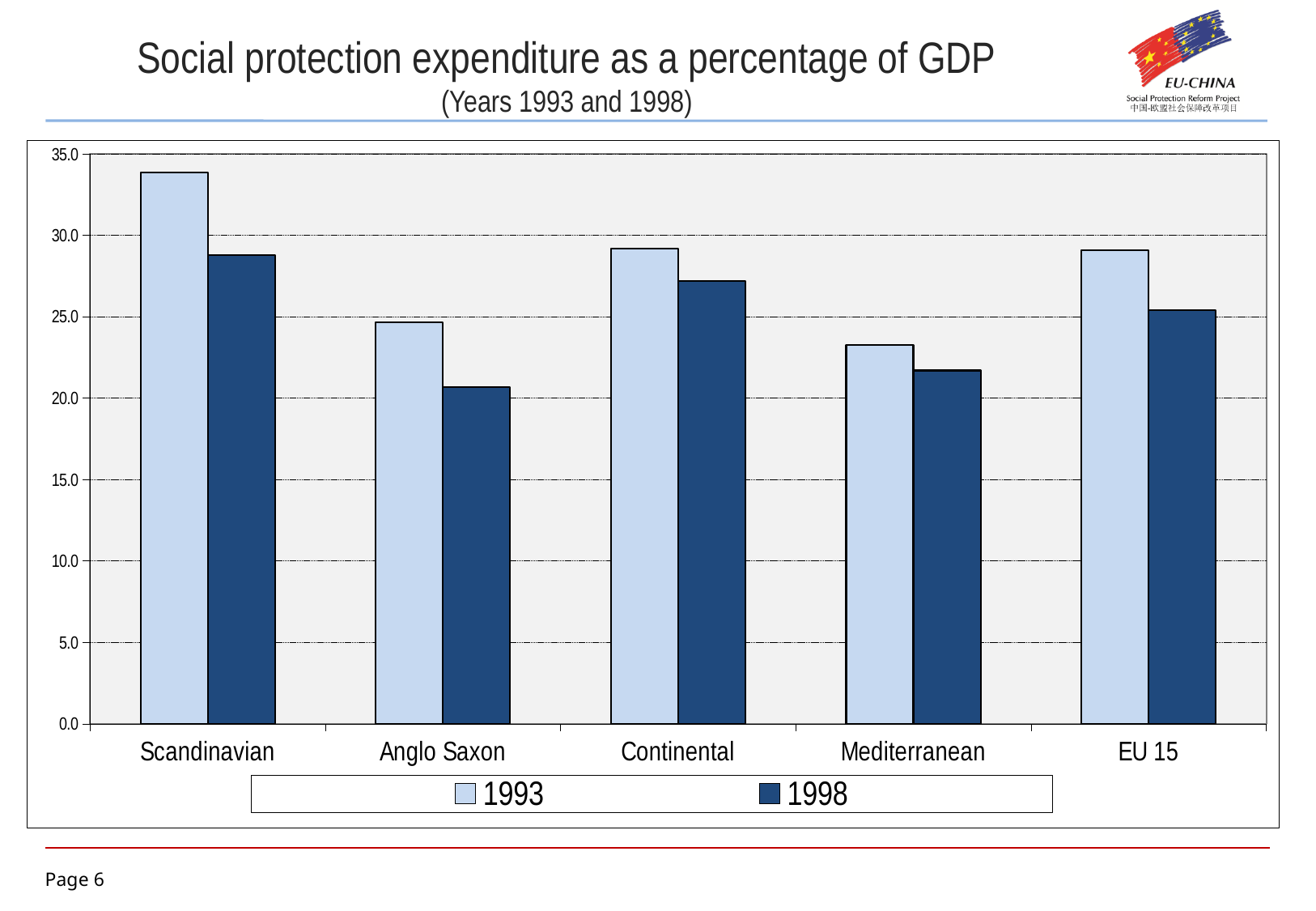
Is the 1993 value for Mediterranean greater or less than 25.0? less Is the 1998 value for Scandinavian greater or less than 30.0? less Which category has the highest value for 1993? Scandinavian How many series does the legend list? 2 Which category has the lowest value for 1993? Mediterranean How many categories are shown on the x axis of the chart? 5 For each category, is the 1998 bar higher or lower than the 1993 bar? lower Which category has the highest value for 1998? Scandinavian Is the 1993 value for Scandinavian greater or less than 30.0? greater What kind of chart is shown on the slide? bar chart Which is larger: the 1998 value for Scandinavian or the 1993 value for Anglo Saxon? 1998 value for Scandinavian